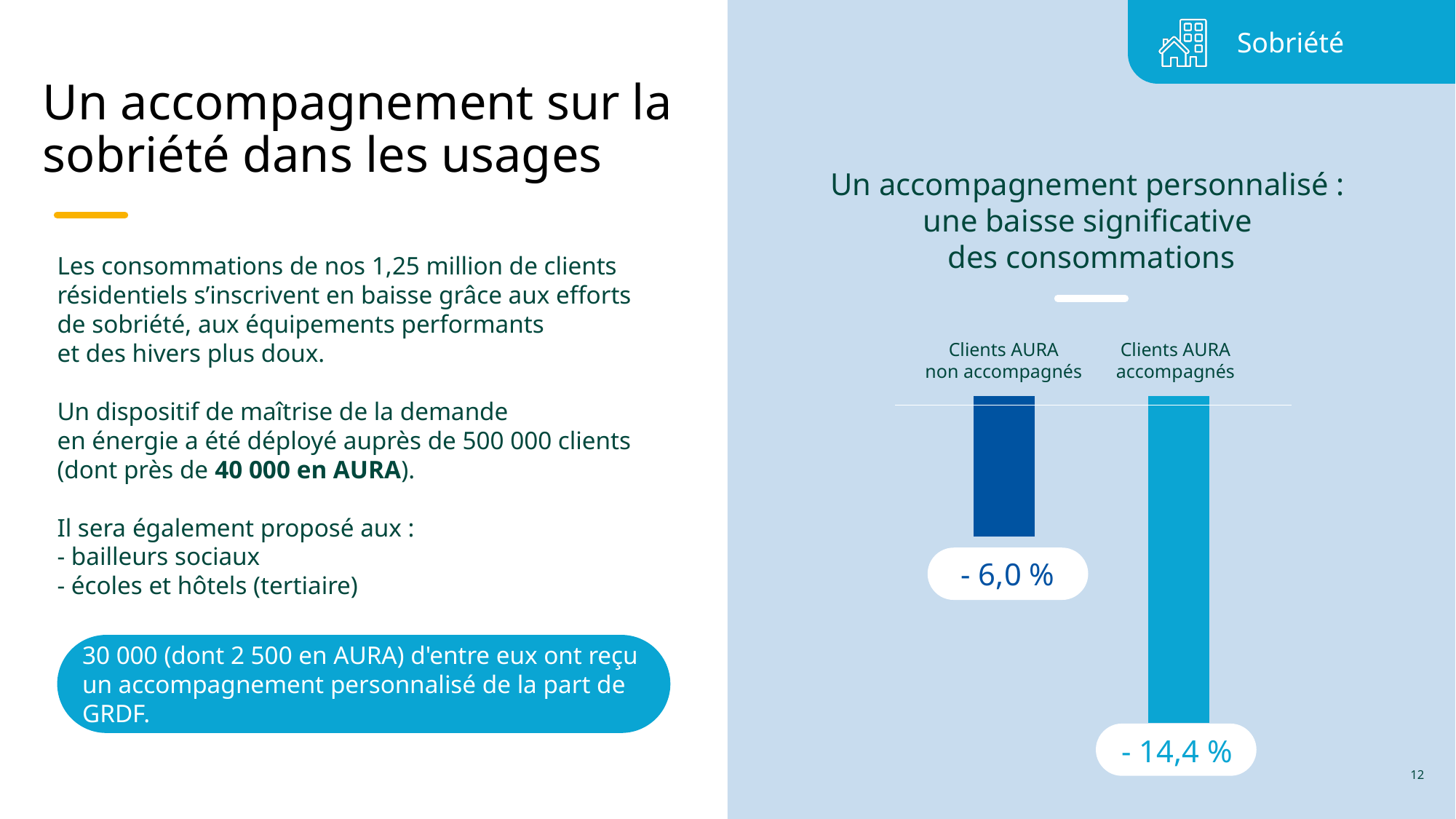
What value is shown for Clients AURA non accompagnés? - 6,0 % What is the title of the chart? Un accompagnement personnalisé : une baisse significative des consommations How many categories (bars) does the chart show? 2 What is the difference in percentage points between the values for Clients AURA accompagnés and Clients AURA non accompagnés? 8,4 points What colour is the bar for Clients AURA accompagnés? Light blue Which category has the lowest value on the chart? Clients AURA accompagnés What value is shown for Clients AURA accompagnés? - 14,4 % Which category shows the larger decrease in consumption? Clients AURA accompagnés What kind of chart is shown on the slide? Bar chart Is the value for Clients AURA non accompagnés larger or smaller than the value for Clients AURA accompagnés? Larger Which category has the highest value on the chart? Clients AURA non accompagnés